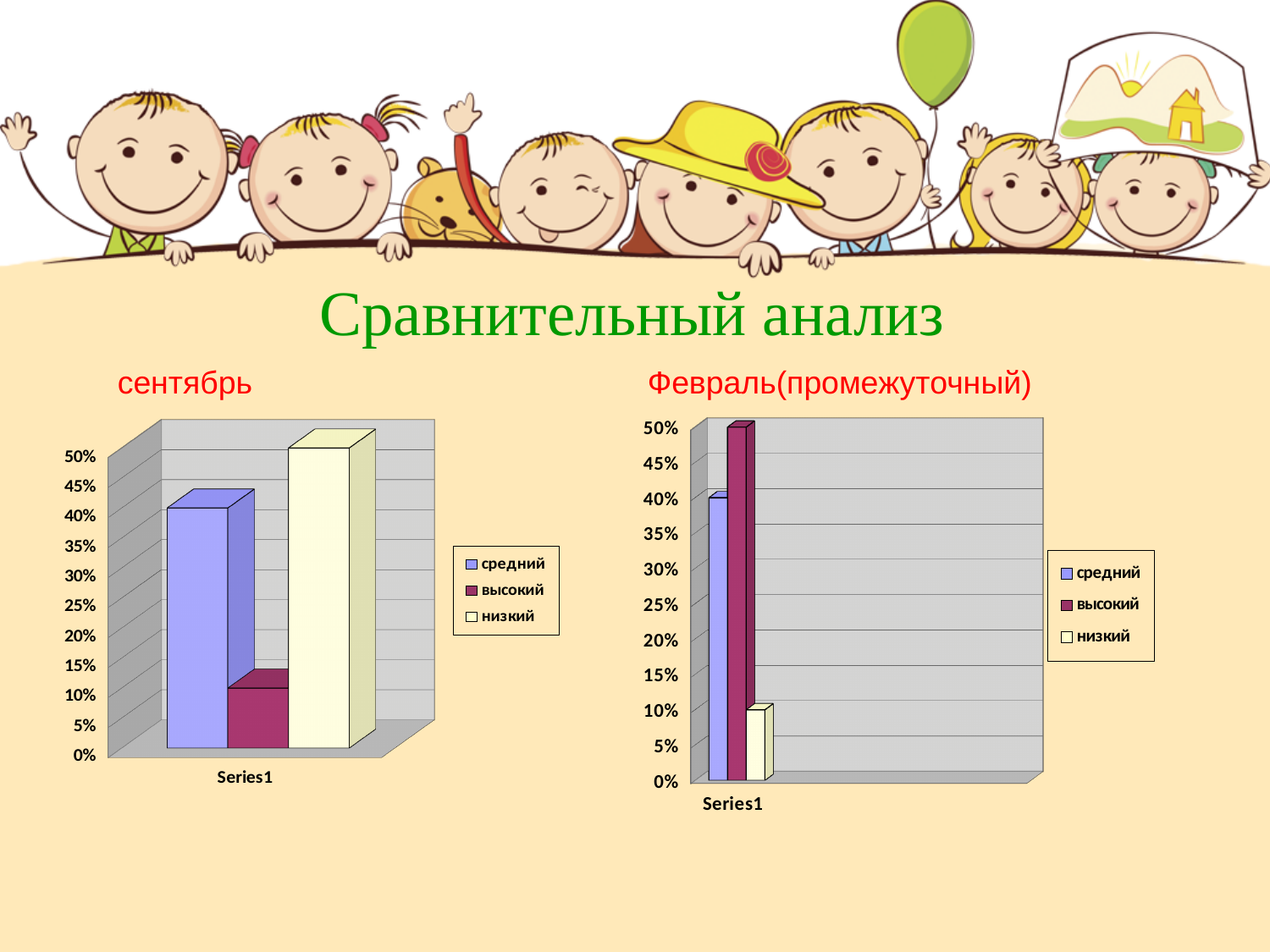
In the Февраль(промежуточный) chart, which series has the highest bar? высокий What kind of chart is the сентябрь chart? bar chart In the Февраль(промежуточный) chart, is the value for низкий greater or less than 20%? less In the сентябрь chart, is the value for высокий greater or less than 20%? less In the сентябрь chart, which series has the lowest bar? высокий In the сентябрь chart, which is larger, средний or высокий? средний In the сентябрь chart, which series has the highest bar? низкий In the Февраль(промежуточный) chart, which is larger, средний or высокий? высокий How many series does the legend of the сентябрь chart list? 3 In the Февраль(промежуточный) chart, which series has the lowest bar? низкий In the сентябрь chart, is the value for средний greater or less than 30%? greater What is the title of the slide above the two charts? Сравнительный анализ